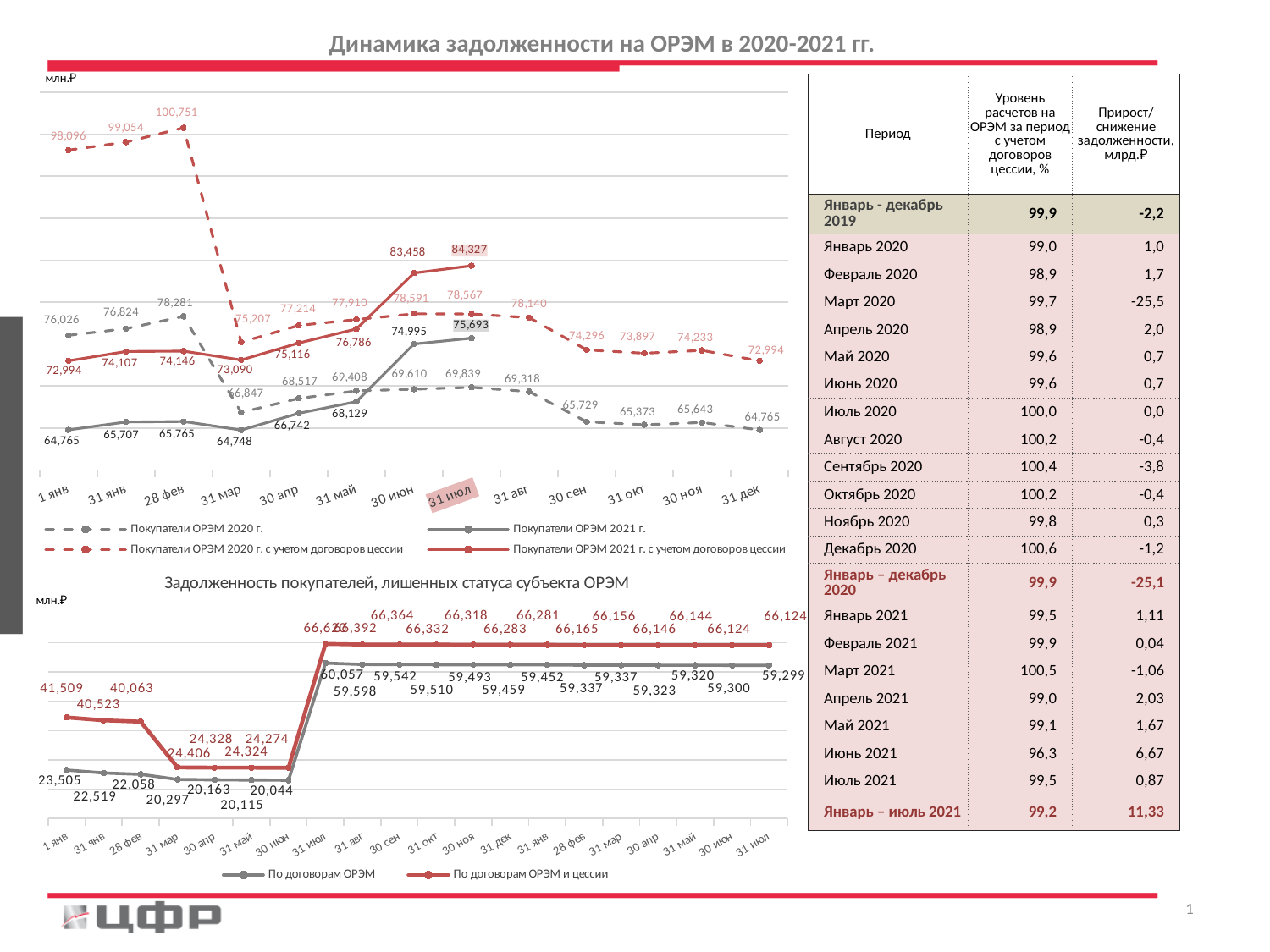
On the top chart 'Динамика задолженности на ОРЭМ в 2020-2021 гг.', at which date is the 'Покупатели ОРЭМ 2021 г.' series lowest? 31 мар On the top chart 'Динамика задолженности на ОРЭМ в 2020-2021 гг.', how many series does the legend list? 4 On the top chart 'Динамика задолженности на ОРЭМ в 2020-2021 гг.', which is larger at 30 июн: 'Покупатели ОРЭМ 2020 г.' or 'Покупатели ОРЭМ 2021 г.'? Покупатели ОРЭМ 2021 г. On the bottom chart 'Задолженность покупателей, лишенных статуса субъекта ОРЭМ', how many series does the legend list? 2 On the bottom chart 'Задолженность покупателей, лишенных статуса субъекта ОРЭМ', what is the value for 'По договорам ОРЭМ и цессии' at the first point (1 янв)? 41,509 On the top chart 'Динамика задолженности на ОРЭМ в 2020-2021 гг.', what is the value for 'Покупатели ОРЭМ 2021 г. с учетом договоров цессии' at 31 июл? 84,327 On the bottom chart 'Задолженность покупателей, лишенных статуса субъекта ОРЭМ', what is the value for 'По договорам ОРЭМ' at the last point (31 июл)? 59,299 On the top chart 'Динамика задолженности на ОРЭМ в 2020-2021 гг.', at which date is the 'Покупатели ОРЭМ 2020 г. с учетом договоров цессии' series highest? 28 фев On the bottom chart 'Задолженность покупателей, лишенных статуса субъекта ОРЭМ', what is the difference between 'По договорам ОРЭМ и цессии' and 'По договорам ОРЭМ' at the last point (31 июл)? 6,825 On the top chart 'Динамика задолженности на ОРЭМ в 2020-2021 гг.', what is the value for 'Покупатели ОРЭМ 2020 г. с учетом договоров цессии' at 28 фев? 100,751 On the top chart 'Динамика задолженности на ОРЭМ в 2020-2021 гг.', what kind of chart is it? line chart On the top chart 'Динамика задолженности на ОРЭМ в 2020-2021 гг.', what is the difference between 'Покупатели ОРЭМ 2021 г. с учетом договоров цессии' and 'Покупатели ОРЭМ 2021 г.' at 31 июл? 8,634